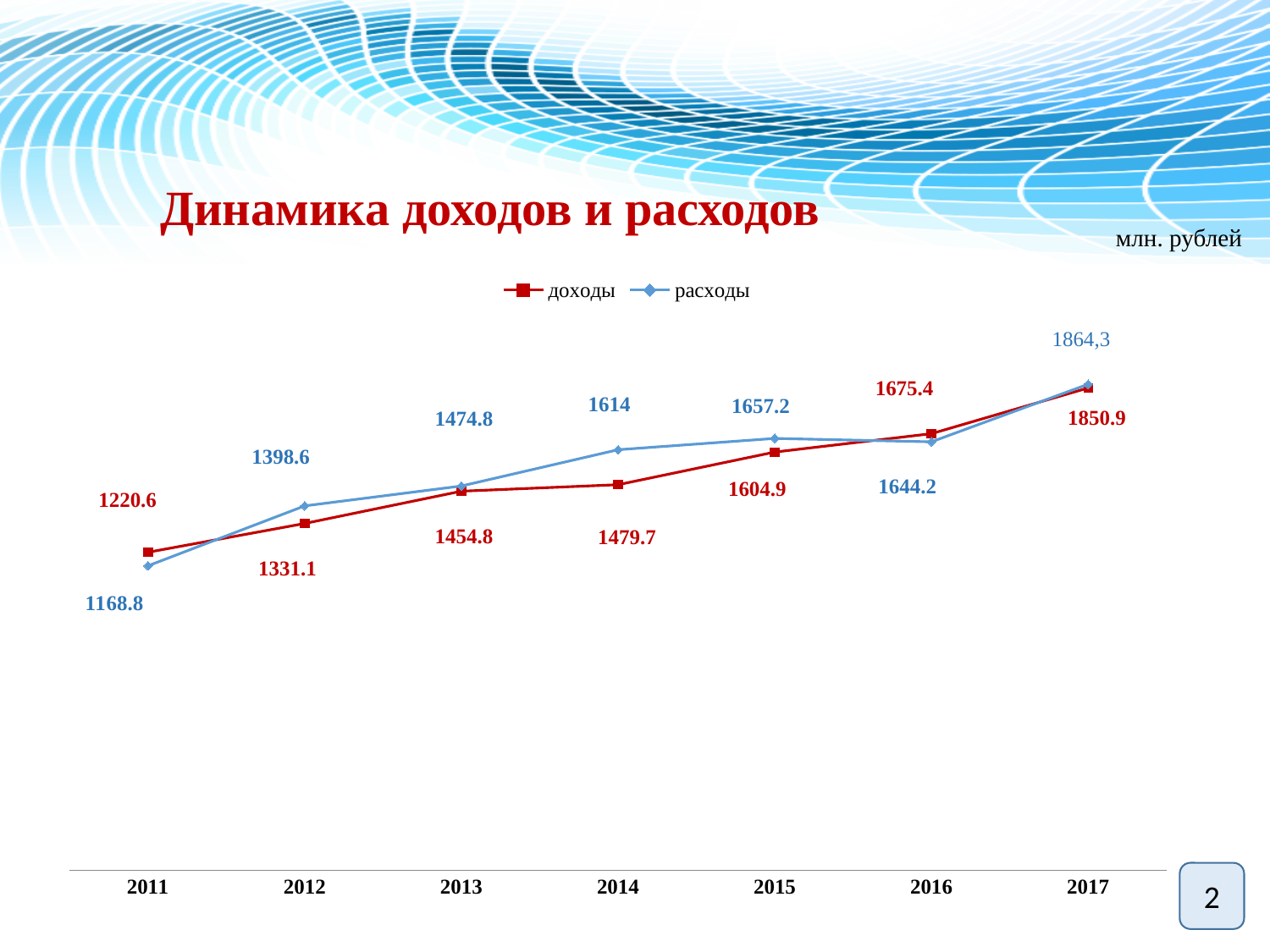
What type of chart is shown on the slide? line chart Does доходы rise or fall from 2011 to 2017? rise What is the difference between доходы and расходы in 2011? 51.8 In which year is доходы highest? 2017 What is the value of доходы in 2011? 1220.6 What is the value of расходы in 2014? 1614 Which is larger in 2014, доходы or расходы? расходы What is the value of расходы in 2017? 1864,3 In which year is расходы lowest? 2011 How many series does the legend list? 2 What is the title of the chart? Динамика доходов и расходов How many years are shown on the x axis? 7